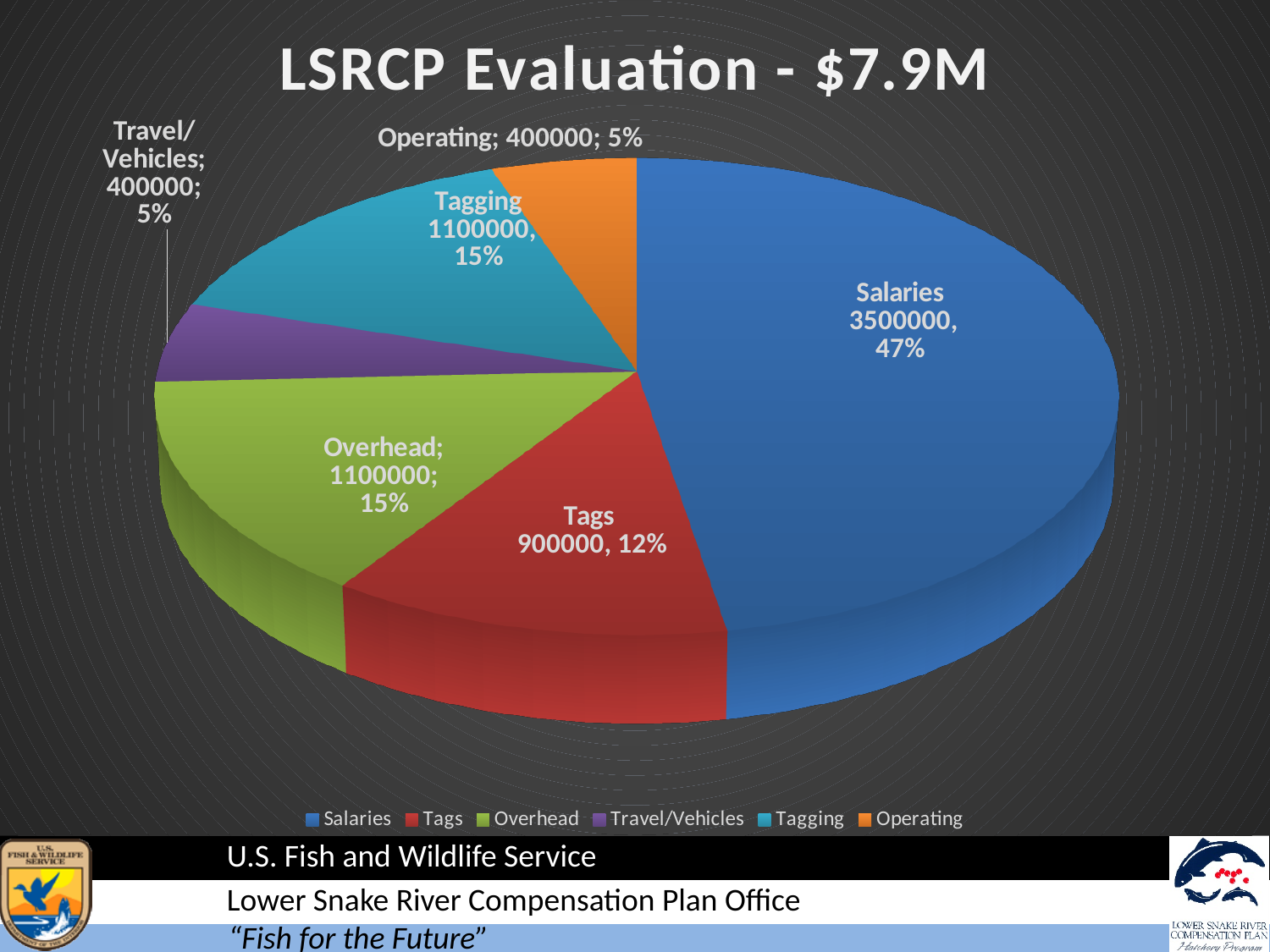
What is the value for Tags? 900000 Which category is shown in orange in the legend? Operating What percentage share of the pie is Salaries? 47% Which category has the largest slice? Salaries Which is larger, the value for Tags or the value for Overhead? Overhead What is the value for Salaries? 3500000 How many slices does the pie chart have? 6 What is the difference between the Salaries value and the Overhead value? 2400000 What kind of chart is shown on the slide? Pie chart What percentage share of the pie is Tagging? 15% What is the title of the chart? LSRCP Evaluation - $7.9M What is the value for Operating? 400000